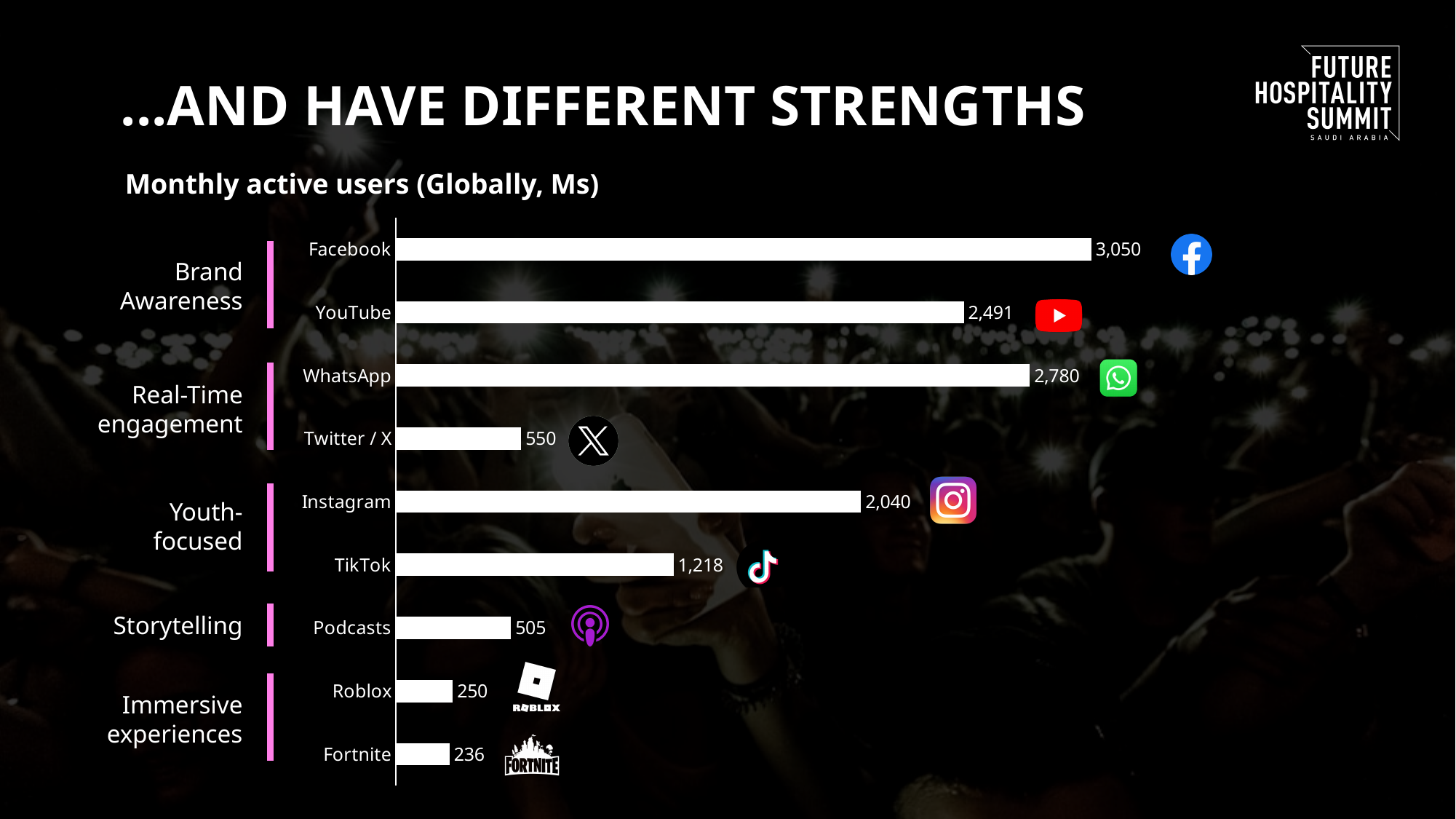
What is the difference in monthly active users between Instagram and TikTok? 822 Which has more monthly active users, Roblox or Fortnite? Roblox Which has more monthly active users, WhatsApp or YouTube? WhatsApp What is the monthly active users value for WhatsApp? 2,780 Which platform has the highest monthly active users? Facebook How many platforms are plotted in the chart? 9 What is the title of the chart? Monthly active users (Globally, Ms) What is the difference in monthly active users between Facebook and YouTube? 559 Which platform has the lowest monthly active users? Fortnite What is the monthly active users value for Facebook? 3,050 What is the monthly active users value for TikTok? 1,218 What kind of chart is shown on the slide? Bar chart